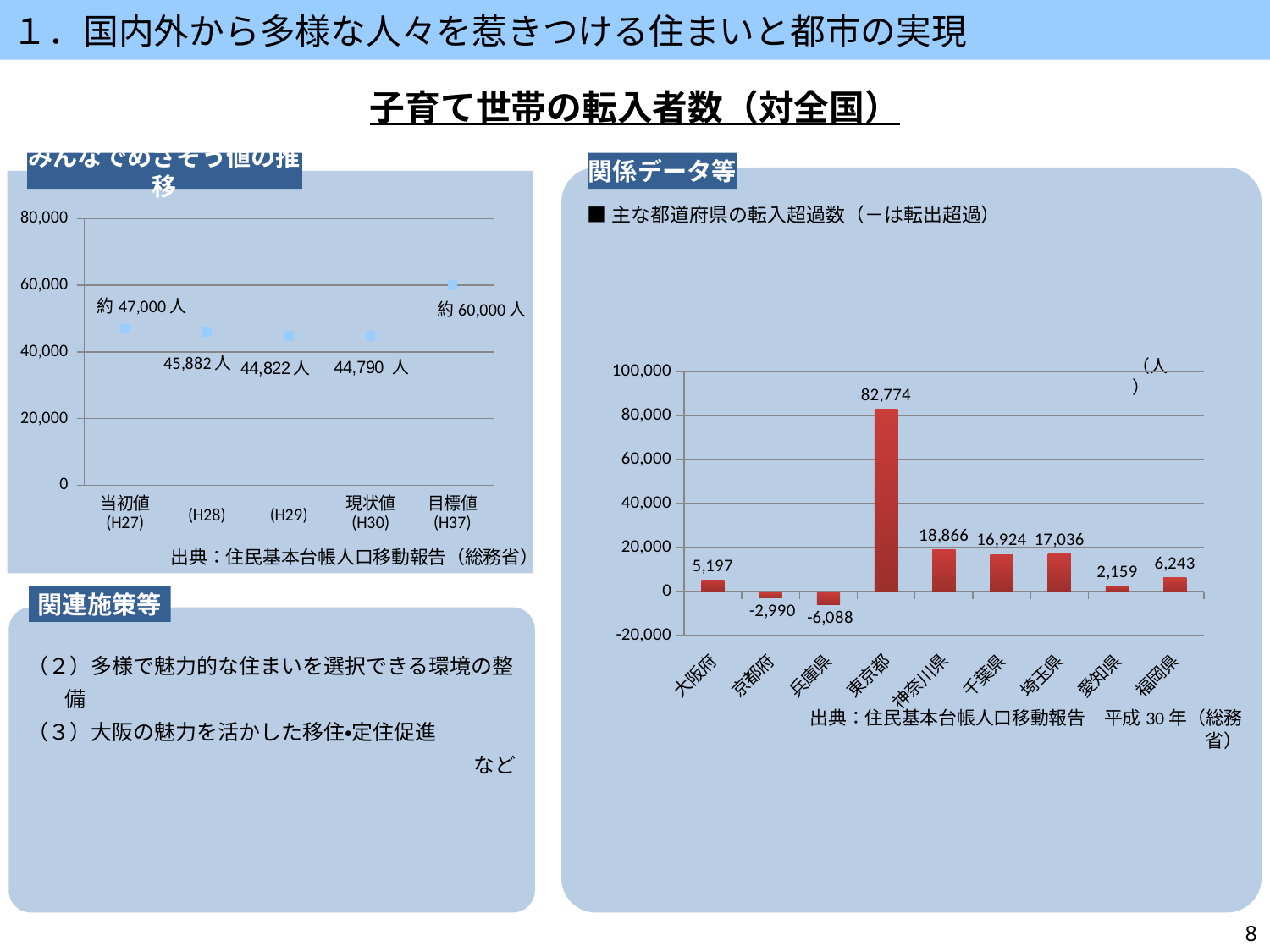
In the right-hand bar chart (主な都道府県の転入超過数), what is the difference between the values for 神奈川県 and 千葉県? 1,942 In the left-hand chart (みんなでめざそう値の推移), what is the value for 現状値 (H30)? 44,790 人 In the left-hand chart (みんなでめざそう値の推移), what is the value for 目標値 (H37)? 約 60,000 人 In the right-hand bar chart (主な都道府県の転入超過数), which prefecture has the lowest value? 兵庫県 In the left-hand chart (みんなでめざそう値の推移), do the values rise or fall from H28 to H30? fall In the left-hand chart (みんなでめざそう値の推移), what is the difference between the values for H28 and H29? 1,060 人 In the right-hand bar chart (主な都道府県の転入超過数), what is the value for 兵庫県? -6,088 How many prefectures are shown in the right-hand bar chart (主な都道府県の転入超過数)? 9 In the right-hand bar chart (主な都道府県の転入超過数), which prefecture has the highest value? 東京都 In the right-hand bar chart (主な都道府県の転入超過数), which is larger, the value for 埼玉県 or 千葉県? 埼玉県 In the right-hand bar chart (主な都道府県の転入超過数), what is the value for 東京都? 82,774 What kind of chart is the right-hand chart (主な都道府県の転入超過数)? bar chart